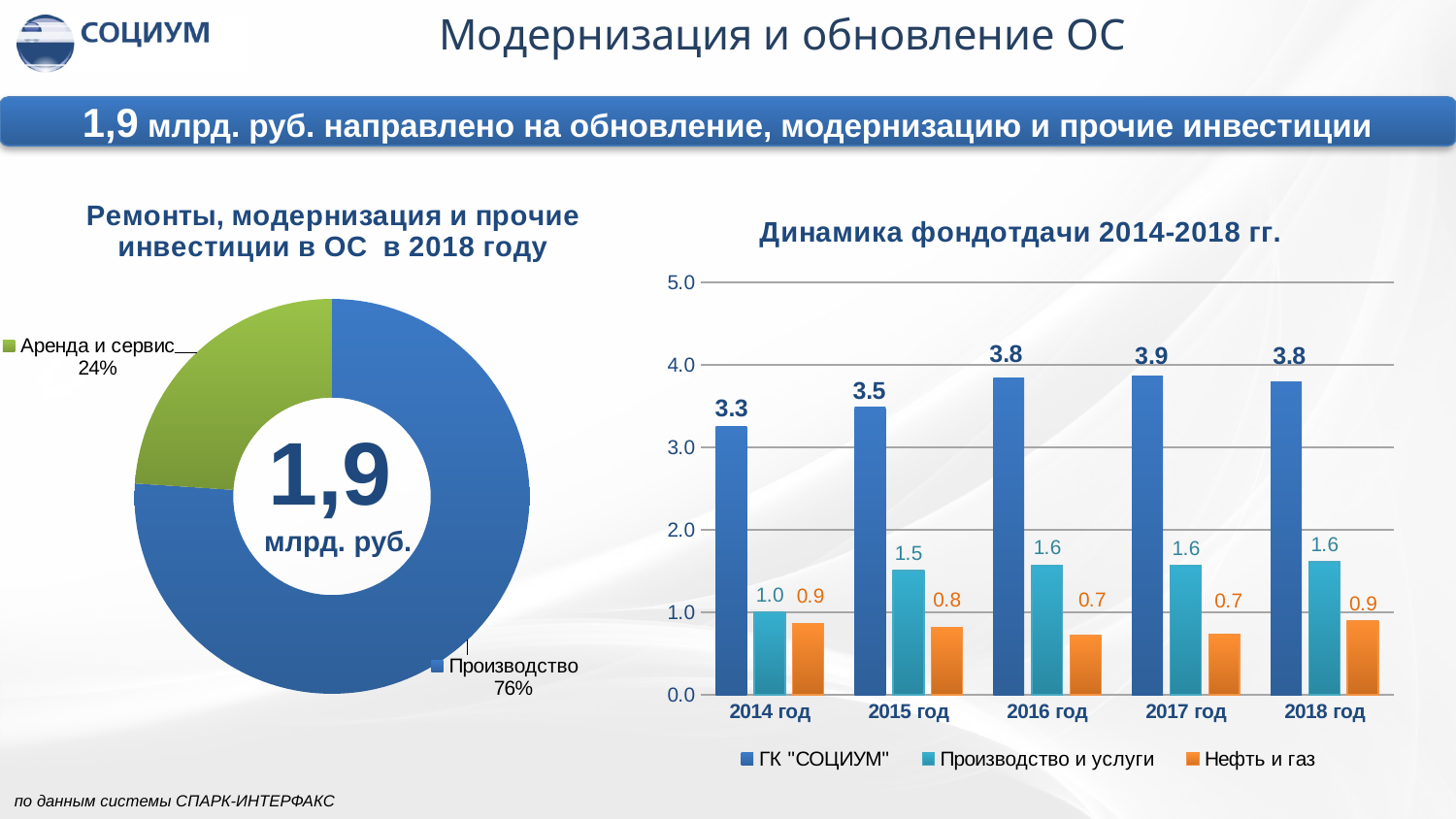
In the chart "Динамика фондотдачи 2014-2018 гг.", does the value for ГК "СОЦИУМ" rise or fall from 2014 год to 2017 год? rise In the doughnut chart "Ремонты, модернизация и прочие инвестиции в ОС в 2018 году", what share does Производство have? 76% In the chart "Динамика фондотдачи 2014-2018 гг.", which is larger in 2014 год: Производство и услуги or Нефть и газ? Производство и услуги In the chart "Динамика фондотдачи 2014-2018 гг.", in which year is the value for ГК "СОЦИУМ" lowest? 2014 год In the chart "Динамика фондотдачи 2014-2018 гг.", in which year is the value for ГК "СОЦИУМ" highest? 2017 год In the chart "Динамика фондотдачи 2014-2018 гг.", how many years are shown on the x axis? 5 In the chart "Динамика фондотдачи 2014-2018 гг.", how many series does the legend list? 3 In the chart "Динамика фондотдачи 2014-2018 гг.", what is the value for Нефть и газ in 2015 год? 0.8 In the chart "Динамика фондотдачи 2014-2018 гг.", what is the difference between ГК "СОЦИУМ" and Производство и услуги in 2018 год? 2.2 In the chart "Динамика фондотдачи 2014-2018 гг.", what is the value for Производство и услуги in 2014 год? 1.0 In the chart "Динамика фондотдачи 2014-2018 гг.", what is the value for ГК "СОЦИУМ" in 2016 год? 3.8 What kind of chart is "Ремонты, модернизация и прочие инвестиции в ОС в 2018 году"? doughnut (pie) chart